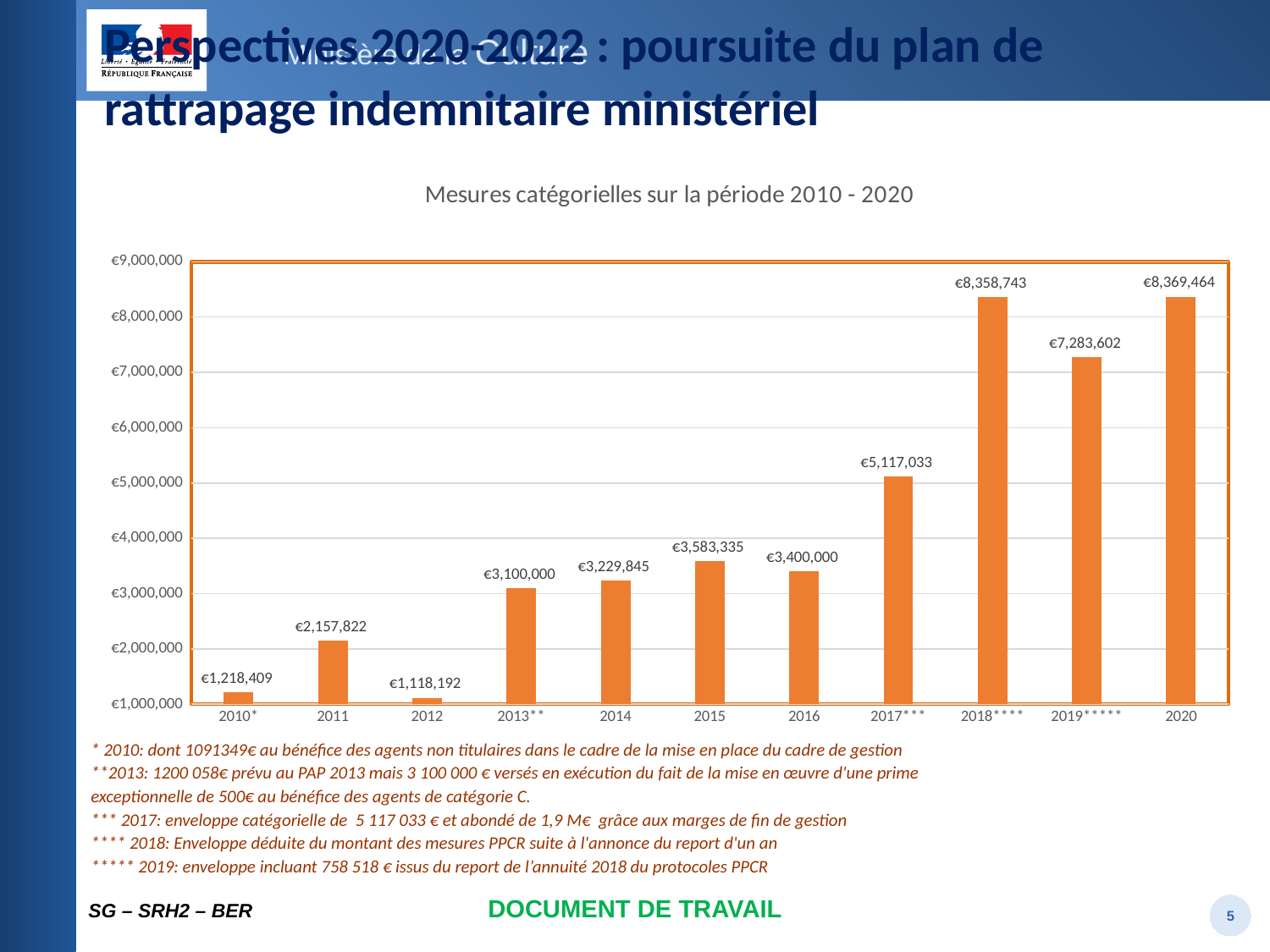
Is the value for 2014 greater or less than €3,000,000? greater Which is larger, the value for 2015 or the value for 2016? 2015 What is the value for 2013** in the chart? €3,100,000 What is the value for 2011 in the chart? €2,157,822 Which year has the lowest value in the chart? 2012 What kind of chart is shown on the slide? bar chart What is the value for 2017*** in the chart? €5,117,033 What is the difference between the values for 2020 and 2019*****? €1,085,862 What is the difference between the values for 2017*** and 2016? €1,717,033 Which year has the highest value in the chart? 2020 What is the value for 2019***** in the chart? €7,283,602 How many years are shown on the x axis of the chart? 11